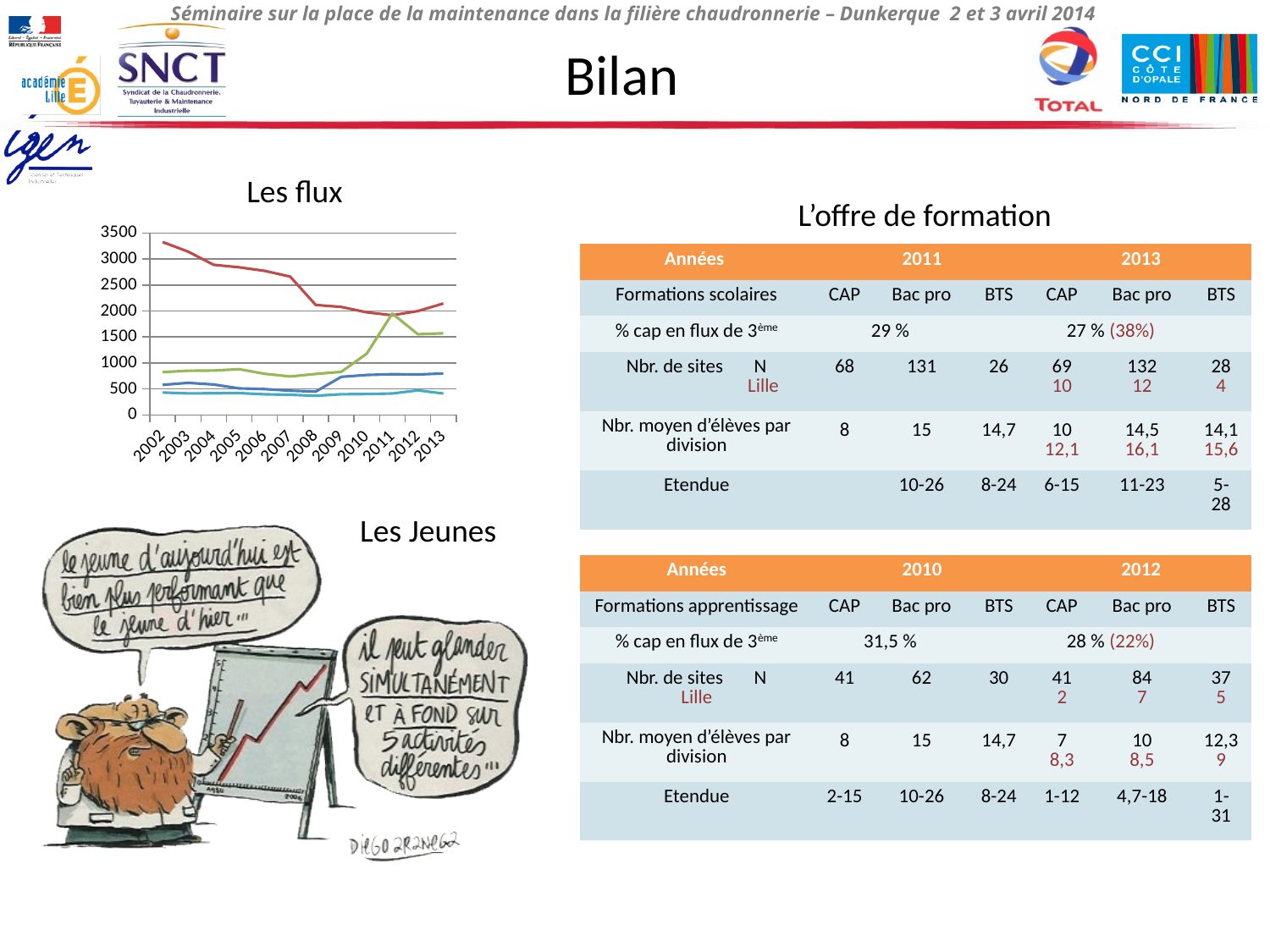
What kind of chart is the 'Les flux' chart? line chart In the 'Les flux' chart, is the value of the red line in 2013 greater or less than 2500? less In the 'Les flux' chart, is the value of the light blue line in 2013 greater or less than 500? less In the 'Les flux' chart, which line has the highest value in 2002? the red line In the 'Les flux' chart, is the value of the green line in 2011 greater or less than 1500? greater In the 'Les flux' chart, does the red line rise or fall from 2002 to 2013? fall In the 'Les flux' chart, which line has the lowest value in 2013? the light blue line In the 'Les flux' chart, does the green line rise or fall between 2009 and 2011? rise How many years are shown on the x axis of the 'Les flux' chart? 12 In the 'Les flux' chart, which is larger in 2002: the red line or the green line? the red line What is the highest tick value shown on the y axis of the 'Les flux' chart? 3500